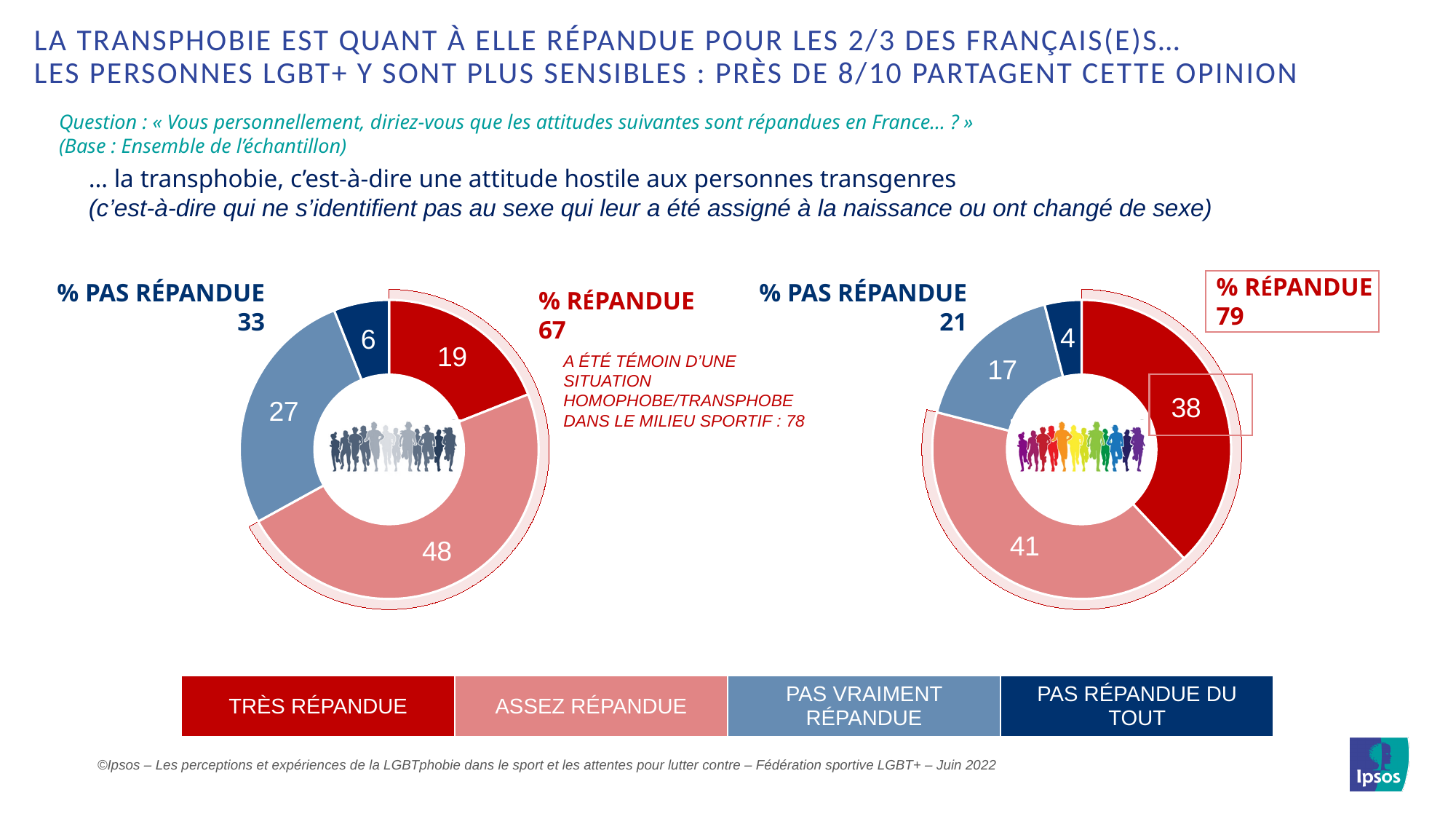
What is the difference between the "Très répandue" values in the right donut chart and the left donut chart? 19 In the right donut chart, what is the value for "Pas vraiment répandue"? 17 In the left donut chart, which category has the largest value? Assez répandue Which colour represents "Pas répandue du tout" in the legend? Dark blue Which is larger: "Pas vraiment répandue" in the left donut chart or in the right donut chart? Left donut chart In the right donut chart, which category has the smallest value? Pas répandue du tout In the right donut chart, what is the value for "Très répandue"? 38 How many categories does each donut chart show? 4 What is the total "% répandue" shown for the right donut chart? 79 In the left donut chart, what is the value for "Assez répandue"? 48 In the left donut chart, what is the value for "Pas répandue du tout"? 6 What type of chart is used on this slide? Donut (pie) chart